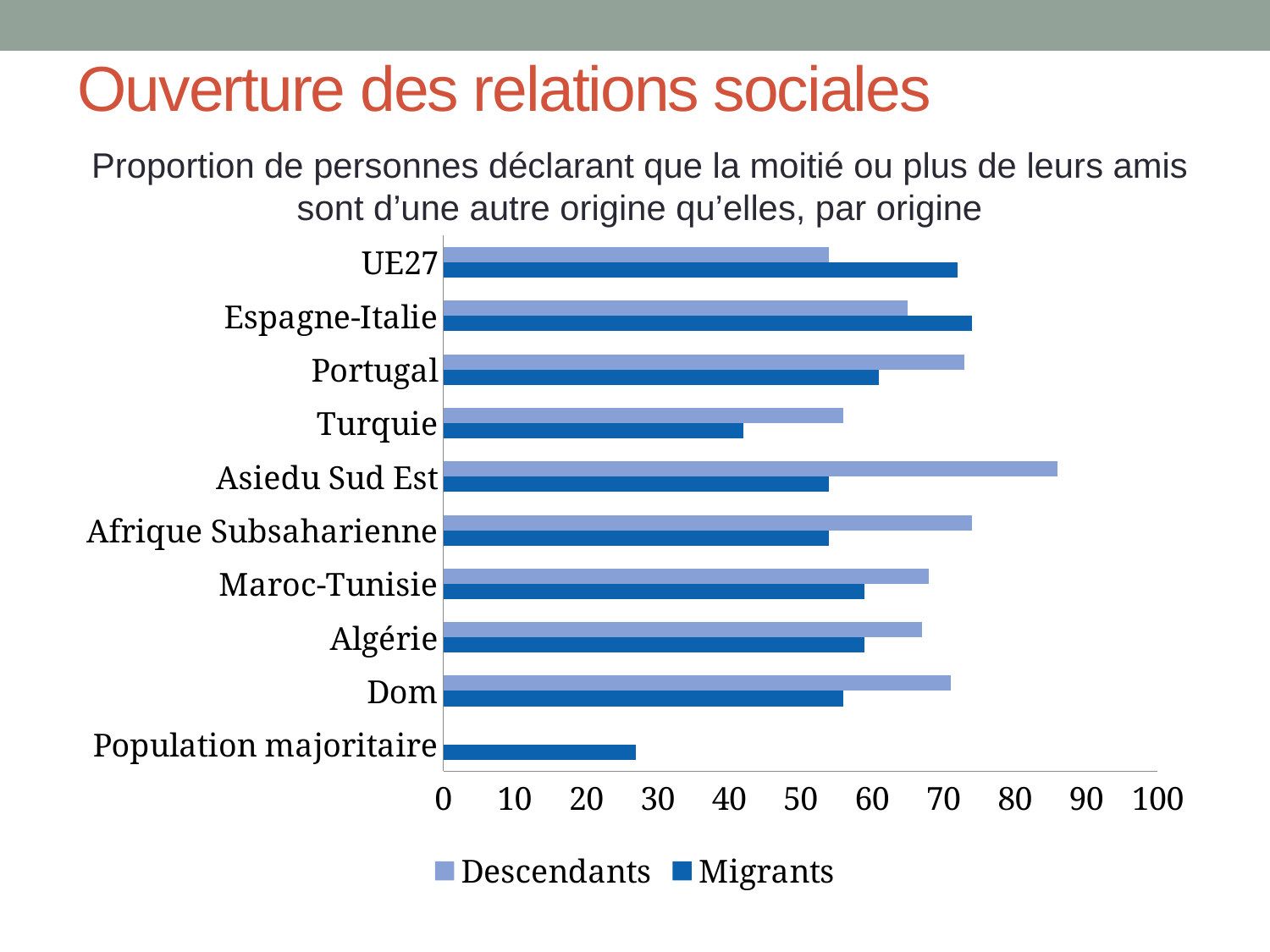
Is the Migrants value for Population majoritaire greater or less than 30? less Which category has the highest value for the Descendants series? Asiedu Sud Est What kind of chart is shown on the slide? Bar chart What is the maximum value shown on the horizontal axis? 100 Which category has the lowest value for the Migrants series? Population majoritaire For Portugal, which series has the larger value, Descendants or Migrants? Descendants How many origin categories are shown on the chart? 10 How many series does the legend list? 2 For UE27, which series has the larger value, Descendants or Migrants? Migrants Is the Descendants value for Asiedu Sud Est greater or less than 80? greater Which series is shown in the darker blue colour? Migrants Is the Migrants value for Turquie greater or less than 50? less